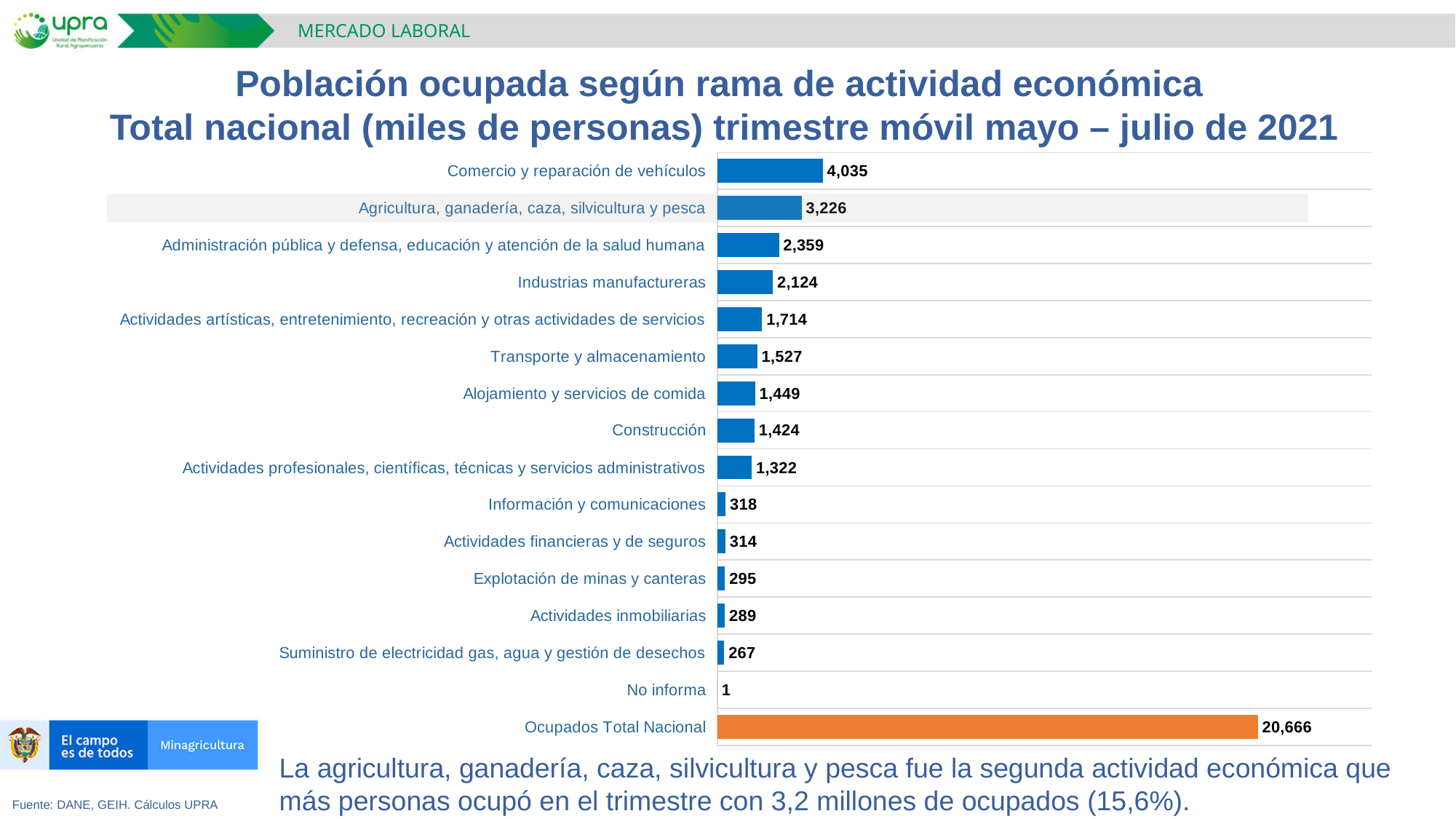
What is the value for Comercio y reparación de vehículos? 4,035 What kind of chart is shown on the slide? Bar chart What is the value for Agricultura, ganadería, caza, silvicultura y pesca? 3,226 What is the difference between Construcción and Alojamiento y servicios de comida? 25 Which is larger, Industrias manufactureras or Transporte y almacenamiento? Industrias manufactureras Excluding the Ocupados Total Nacional bar, which category has the highest value? Comercio y reparación de vehículos How many categories are shown in the chart, including Ocupados Total Nacional? 16 Which bar is shown in orange rather than blue? Ocupados Total Nacional What is the value for Ocupados Total Nacional? 20,666 What is the value for Explotación de minas y canteras? 295 Which category has the lowest value? No informa What is the difference between Comercio y reparación de vehículos and Agricultura, ganadería, caza, silvicultura y pesca? 809